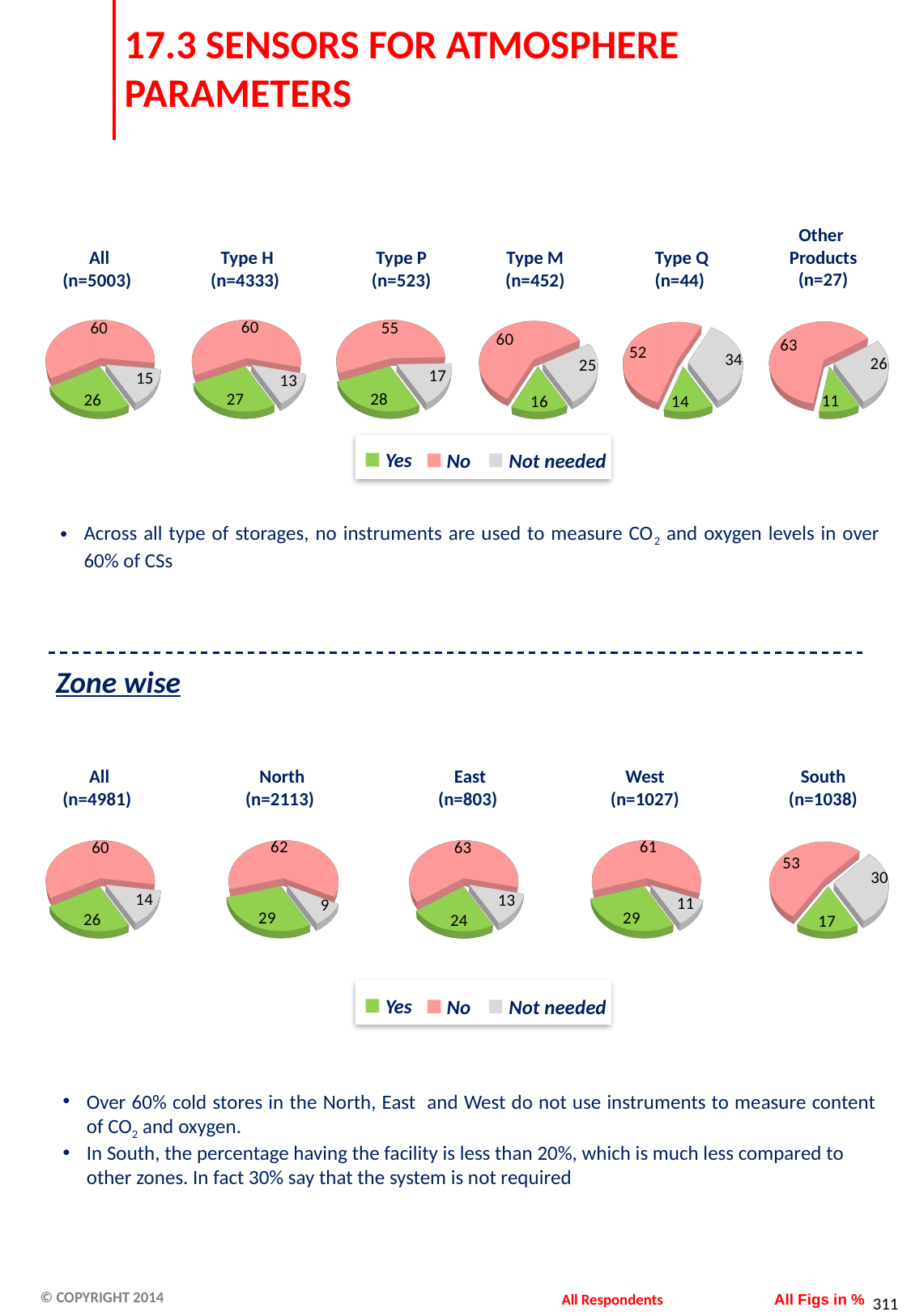
What type of chart is used to show the sensor data on this slide? Pie chart In the top row of pie charts, which is larger: the 'Yes' value for Type M or the 'Yes' value for Type Q? Type M In the top row of pie charts, what is the 'No' value for Type P (n=523)? 55 In the top row of pie charts, what is the 'Yes' value for Other Products (n=27)? 11 In the Zone wise pie charts, which zone has the highest 'Not needed' value? South In the top row of pie charts, what is the 'Not needed' value for Type Q (n=44)? 34 How many pie charts are shown in the Zone wise section? 5 In the Zone wise pie charts, what is the 'Yes' value for South (n=1038)? 17 In the Zone wise pie charts, what is the 'Not needed' value for North (n=2113)? 9 How many series does the legend list for the pie charts? 3 In the top row of pie charts, which storage type has the lowest 'Yes' value? Other Products In the Zone wise pie charts, what is the difference between the 'No' values for East (n=803) and South (n=1038)? 10